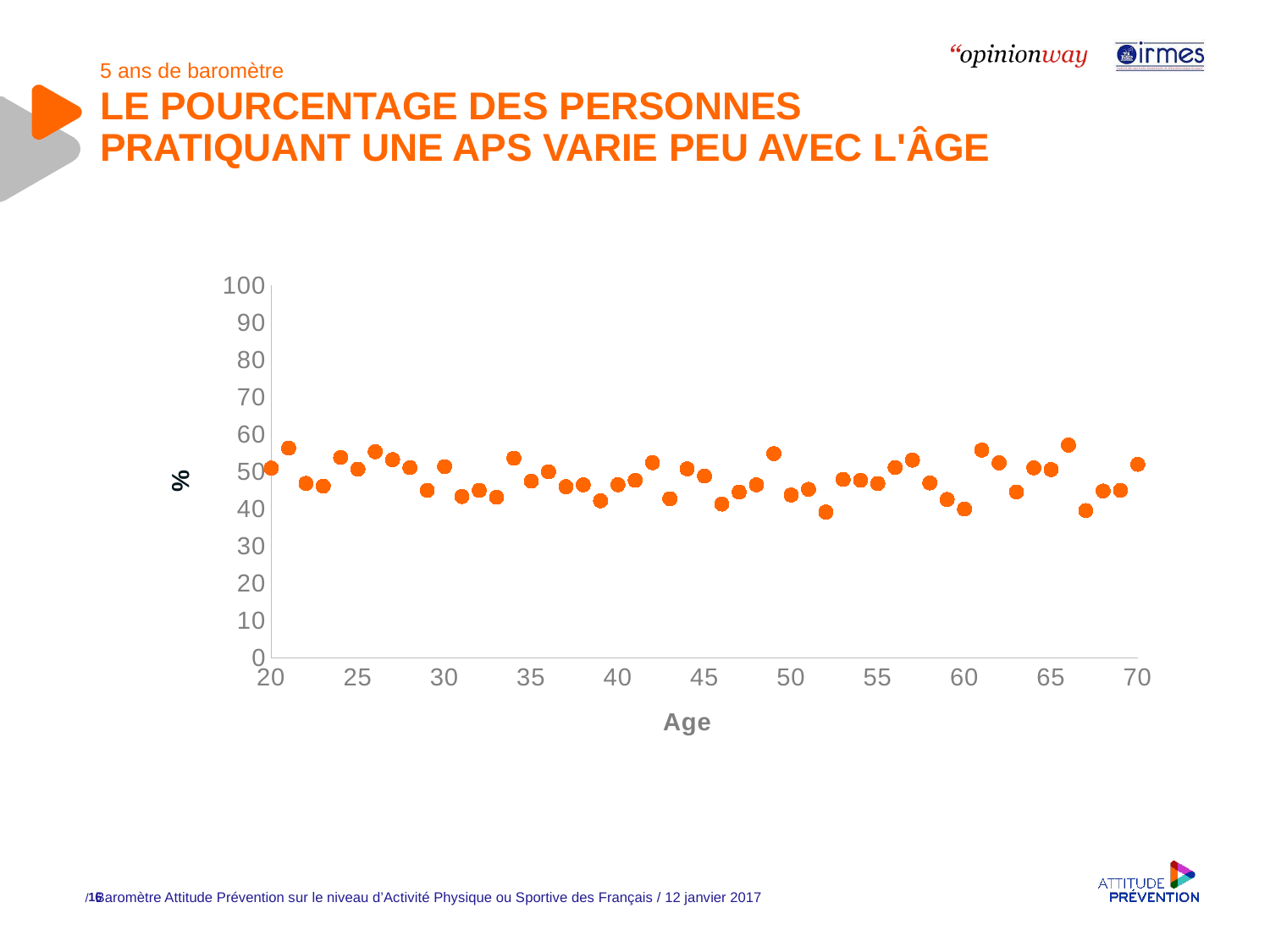
What is the label of the y axis? % Are any of the plotted values greater than 60? no Is the value for age 21 greater or less than 50? greater Are any of the plotted values less than 30? no What is the label of the x axis? Age What kind of chart is shown on the slide? scatter plot Do the values show a clear rising or falling trend as age increases from 20 to 70? no, they stay roughly flat What is the range of ages shown on the x axis? 20 to 70